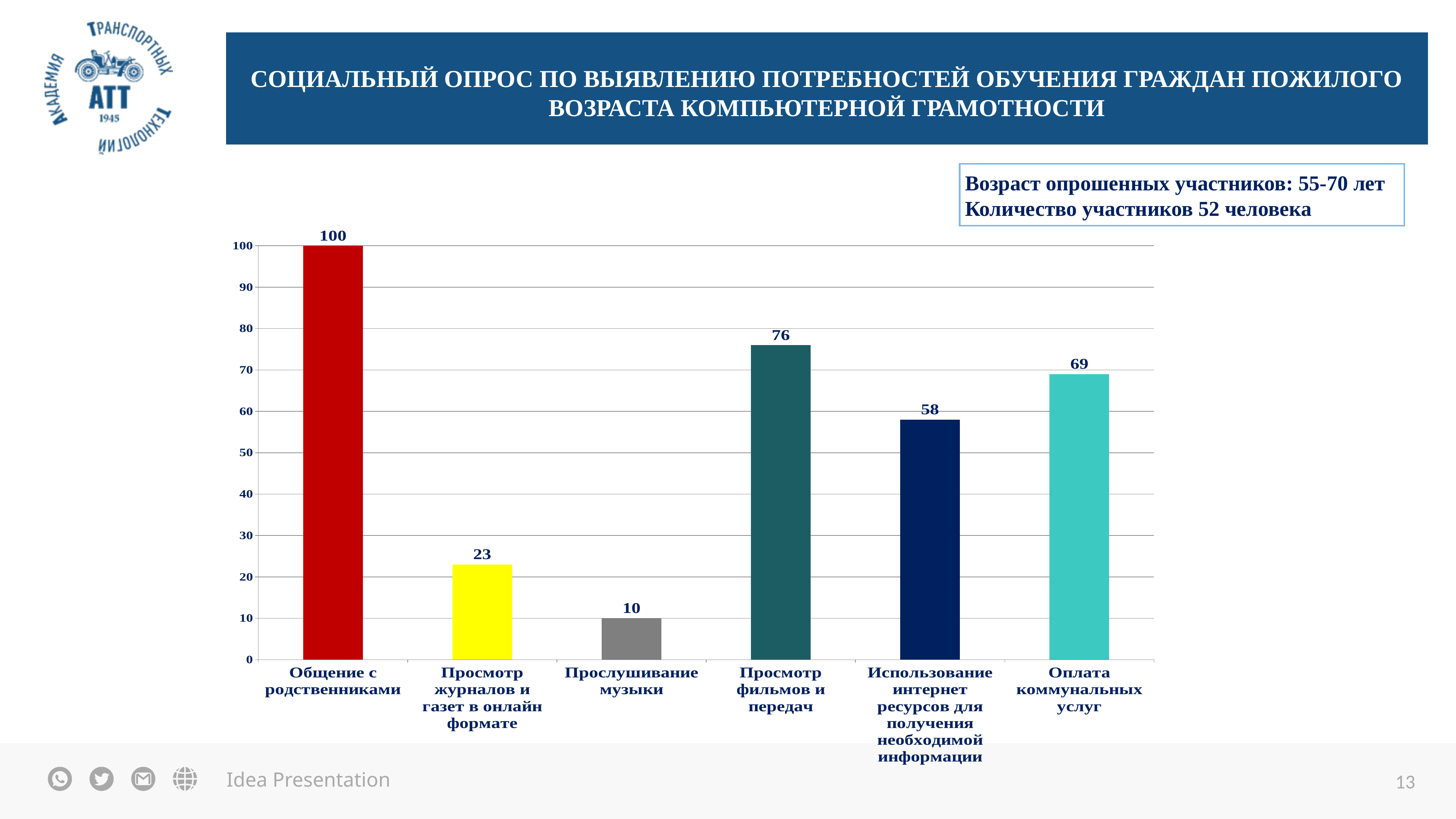
What is the value for "Общение с родственниками"? 100 What is the difference between the values for "Просмотр фильмов и передач" and "Использование интернет ресурсов для получения необходимой информации"? 18 Which is larger: the value for "Оплата коммунальных услуг" or the value for "Просмотр журналов и газет в онлайн формате"? Оплата коммунальных услуг Is the value for "Использование интернет ресурсов для получения необходимой информации" greater or less than 50? greater What is the value for "Оплата коммунальных услуг"? 69 How many categories are shown in the chart? 6 What is the value for "Прослушивание музыки"? 10 Which category has the highest value? Общение с родственниками Which category has the lowest value? Прослушивание музыки What is the value for "Просмотр фильмов и передач"? 76 What colour is the bar for "Общение с родственниками"? red What kind of chart is shown on the slide? bar chart